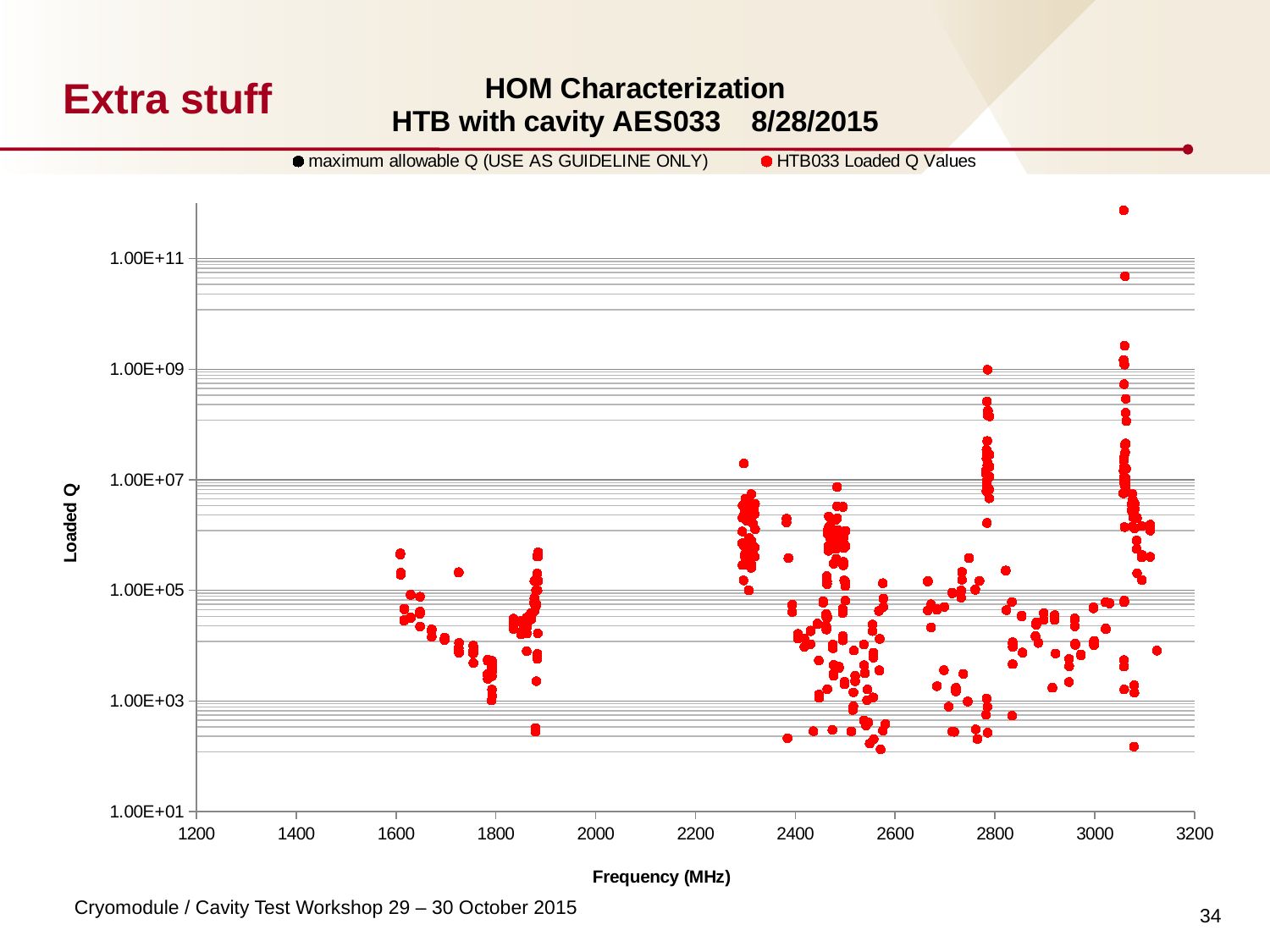
Is the highest HTB033 Loaded Q value plotted near 2800 MHz greater or less than 1.00E+07? greater Around which frequency on the x axis does the highest HTB033 Loaded Q value appear: near 1600 MHz or near 3000 MHz? near 3000 MHz What kind of chart is shown on the slide? scatter chart What is the title of the chart? HOM Characterization HTB with cavity AES033 8/28/2015 Is the highest plotted HTB033 Loaded Q value greater or less than 1.00E+11? greater How many series does the chart legend list? 2 What is the lowest tick value shown on the Loaded Q axis? 1.00E+01 Are the HTB033 Loaded Q values plotted near 1800 MHz greater or less than 1.00E+07? less What is the label of the horizontal axis? Frequency (MHz)